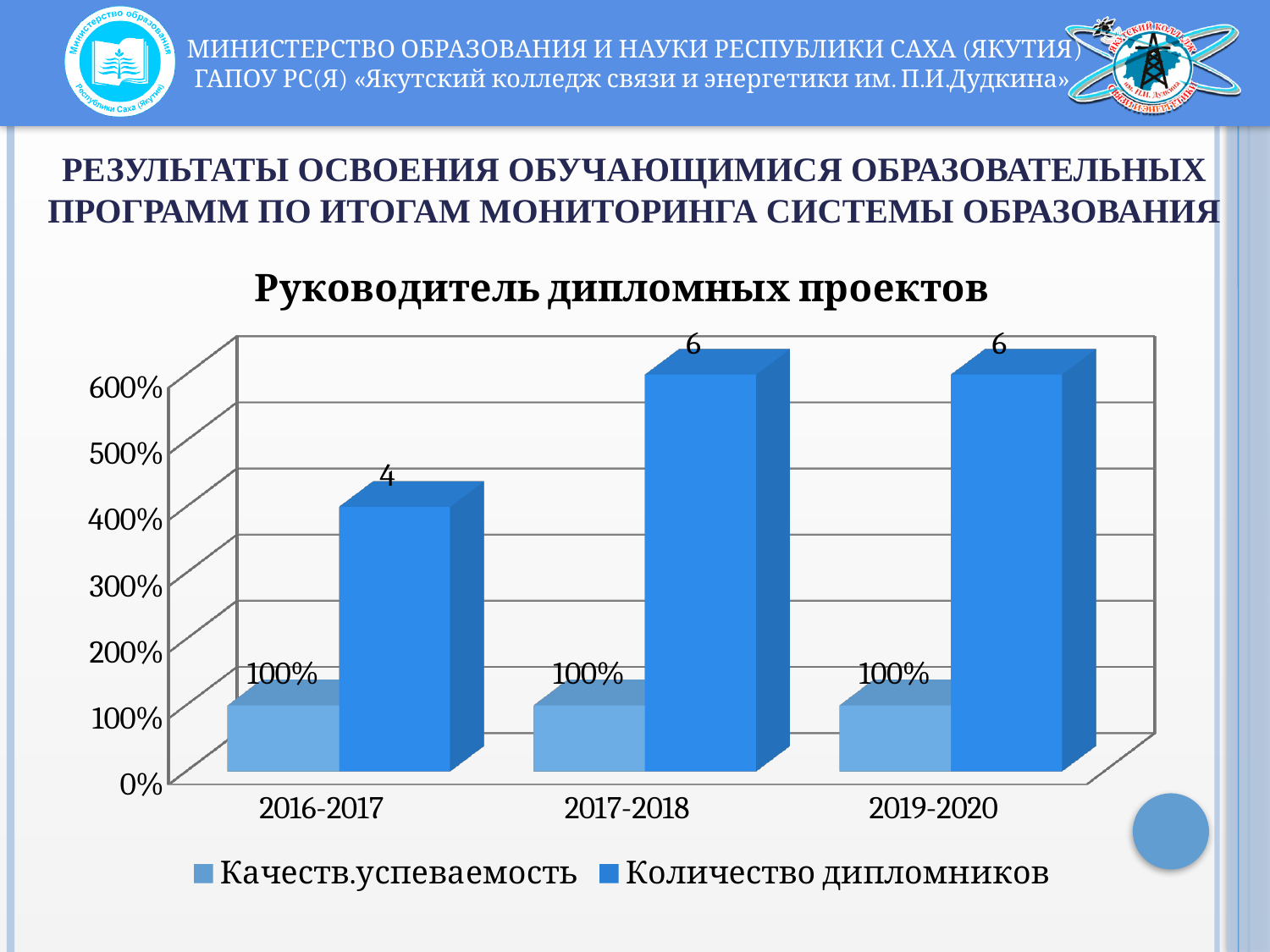
What is the title of the chart? Руководитель дипломных проектов Which legend entry is shown in the lighter blue colour? Качеств.успеваемость What type of chart is shown on the slide? bar chart Which is larger: Количество дипломников for 2016-2017 or for 2019-2020? 2019-2020 Does the value of Качеств.успеваемость change across the three periods? No, it stays at 100% What is the value of Количество дипломников for 2016-2017? 4 What is the difference in Количество дипломников between 2017-2018 and 2016-2017? 2 What is the value of Количество дипломников for 2017-2018? 6 What is the value of Качеств.успеваемость for 2019-2020? 100% Which category has the lowest value for Количество дипломников? 2016-2017 How many series does the legend list? 2 How many categories are shown on the x axis? 3